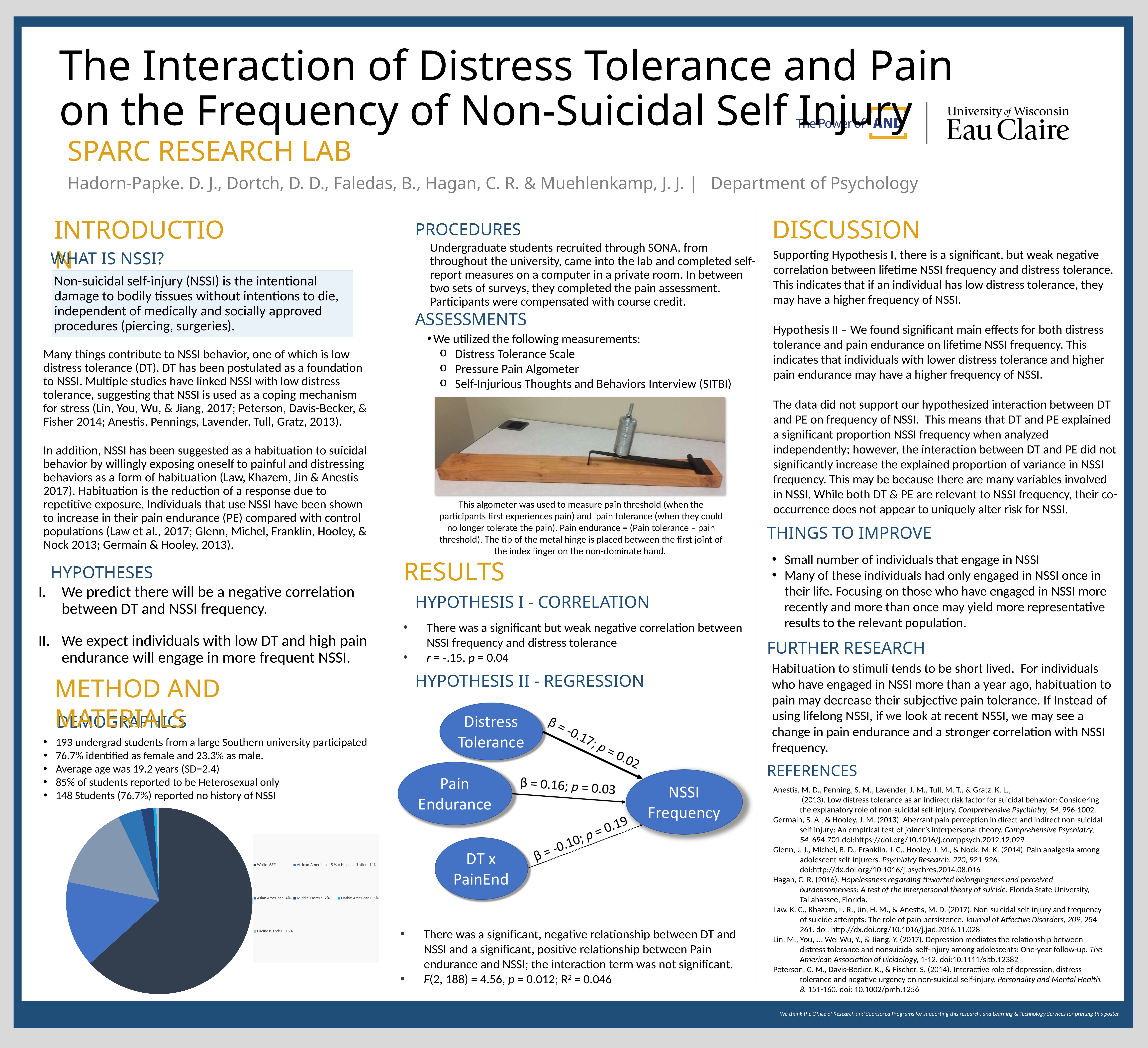
What is the difference in percentage between the White and African-American slices of the pie chart? 48% What percentage does the pie chart show for Pacific Islander participants? 0.5% How many categories does the pie chart's legend list? 7 What percentage does the pie chart show for African-American participants? 15% What share of the pie chart does the White slice represent? 63% What percentage does the pie chart show for Middle Eastern participants? 2% What kind of chart is shown in the bottom-left of the slide? pie chart In the pie chart, which slice is larger: White or Asian American? White Which category has the largest slice in the pie chart? White What percentage does the pie chart show for Hispanic/Latino participants? 14% What percentage of participants does the pie chart show as White? 63% What percentage does the pie chart show for Asian American participants? 4%